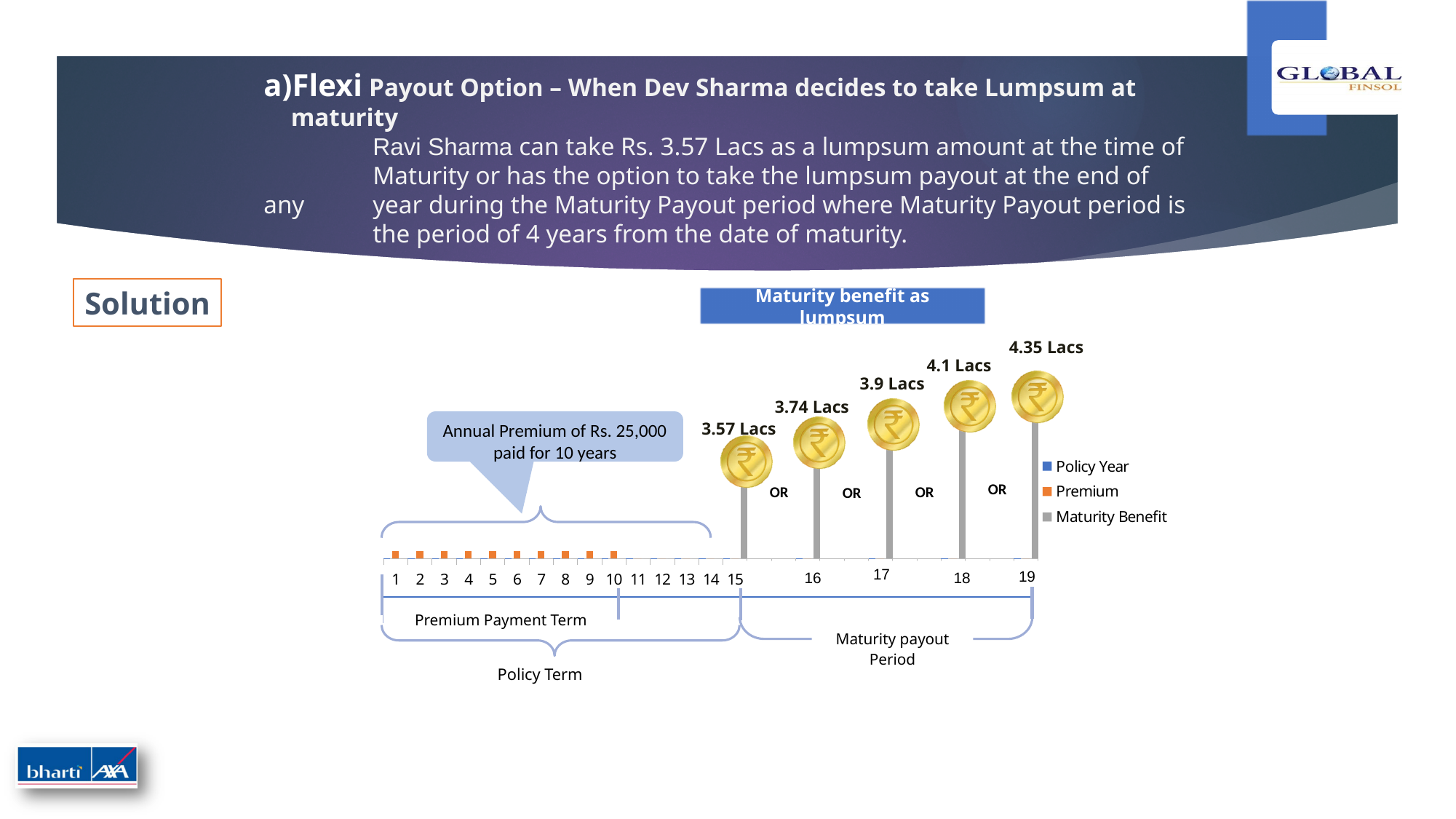
What is the difference between the maturity benefit at year 19 and at year 15? 0.78 Lacs What kind of chart is used to show the premium and maturity benefit? Bar chart Which is larger, the maturity benefit at year 18 or at year 16? Year 18 How many series does the legend list? 3 Do the maturity benefit values rise or fall from policy year 15 to 19? Rise What is the maturity benefit shown for policy year 17? 3.9 Lacs What is the maturity benefit shown for policy year 15? 3.57 Lacs Which policy year has the highest maturity benefit? 19 What is the maturity benefit shown for policy year 19? 4.35 Lacs Which policy year has the lowest maturity benefit among those shown? 15 What is the maturity benefit shown for policy year 16? 3.74 Lacs How many policy years show a maturity benefit bar? 5